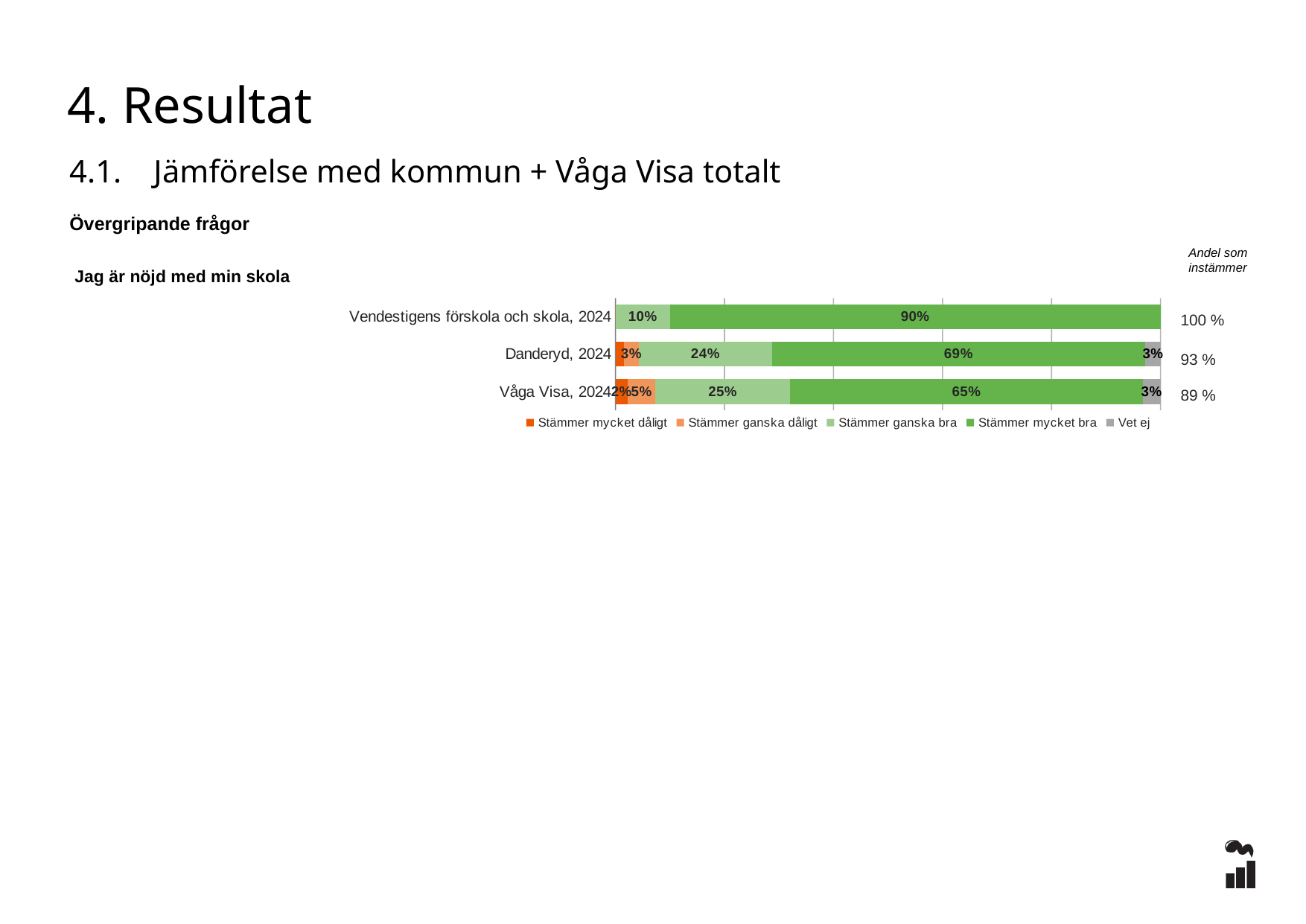
What is the 'Stämmer ganska dåligt' value for Våga Visa, 2024? 5% Which category has the highest 'Stämmer mycket bra' value? Vendestigens förskola och skola, 2024 What is the difference between the 'Stämmer mycket bra' values for Danderyd, 2024 and Våga Visa, 2024? 4% What is the 'Stämmer ganska bra' value for Danderyd, 2024? 24% What is the 'Stämmer mycket bra' value for Vendestigens förskola och skola, 2024? 90% What is the 'Andel som instämmer' value shown for Danderyd, 2024? 93 % How many series does the legend list? 5 What is the title of the question the chart reports on? Jag är nöjd med min skola Which is larger: the 'Stämmer ganska bra' value for Danderyd, 2024 or for Våga Visa, 2024? Våga Visa, 2024 What is the 'Stämmer mycket bra' value for Våga Visa, 2024? 65% How many categories (rows) are plotted in the chart? 3 What kind of chart is shown on the slide? stacked bar chart